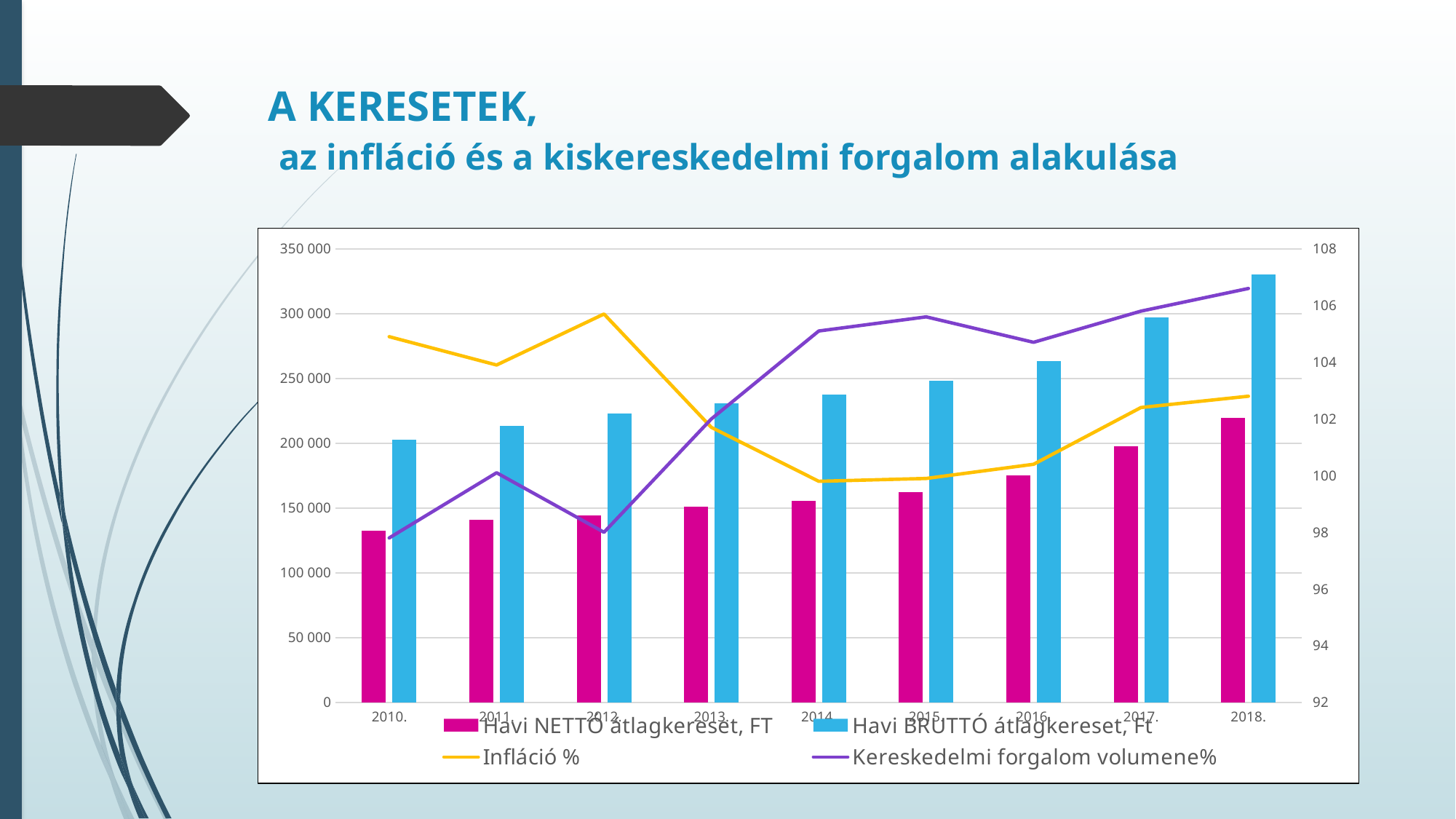
In which year does the Infláció % line reach its highest point? 2012. Is the Infláció % value for 2010 greater or less than 104? greater How many series does the legend list? 4 Is the Havi NETTÓ átlagkereset, FT value for 2010 greater or less than 150 000? less In which year does the Kereskedelmi forgalom volumene% line reach its highest point? 2018. In which year is the Havi NETTÓ átlagkereset, FT bar the lowest? 2010. Is the Havi BRUTTÓ átlagkereset, Ft value for 2018 greater or less than 300 000? greater In which year is the Havi BRUTTÓ átlagkereset, Ft bar the highest? 2018. What kind of chart is shown on the slide? A combined bar and line chart How many years are shown on the x axis? 9 Does the Havi NETTÓ átlagkereset, FT series rise or fall from 2010 to 2018? Rises Which is larger in 2010: the Infláció % value or the Kereskedelmi forgalom volumene% value? Infláció %